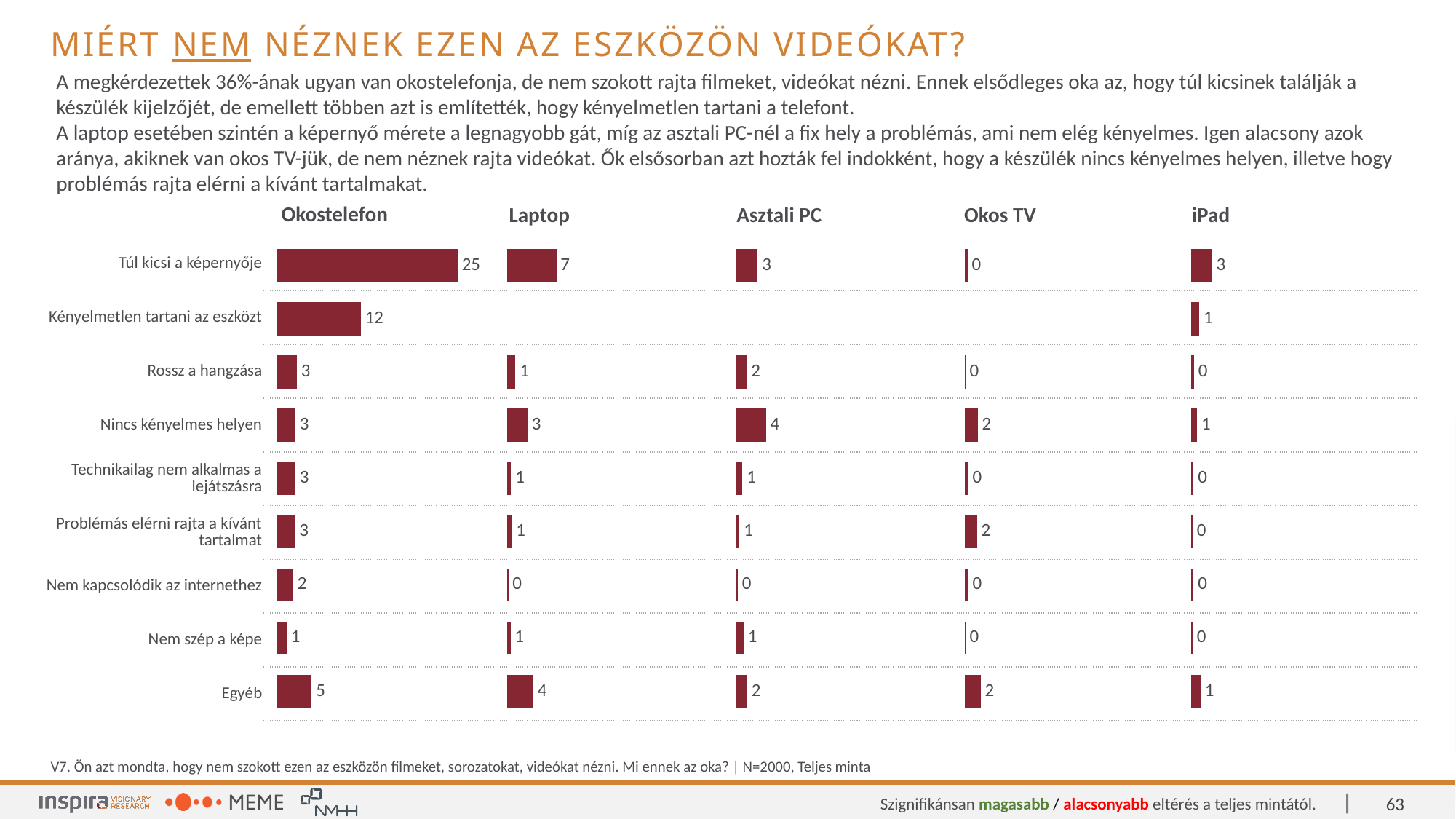
In the Okos TV chart, what is the value for "Problémás elérni rajta a kívánt tartalmat"? 2 In the Asztali PC chart, which is larger: "Nincs kényelmes helyen" or "Rossz a hangzása"? Nincs kényelmes helyen How many charts are shown on the slide? 5 In the Okostelefon chart, what is the difference between "Túl kicsi a képernyője" and "Kényelmetlen tartani az eszközt"? 13 In the iPad chart, what is the value for "Kényelmetlen tartani az eszközt"? 1 In the Laptop chart, what is the value for "Egyéb"? 4 In the Okostelefon chart, what is the value for "Túl kicsi a képernyője"? 25 In the Asztali PC chart, what is the value for "Nincs kényelmes helyen"? 4 What kind of chart is the Okostelefon chart? Bar chart In the Okostelefon chart, which category has the highest value? Túl kicsi a képernyője In the Laptop chart, which category has the highest value? Túl kicsi a képernyője What is the title of the chart positioned furthest to the right? iPad